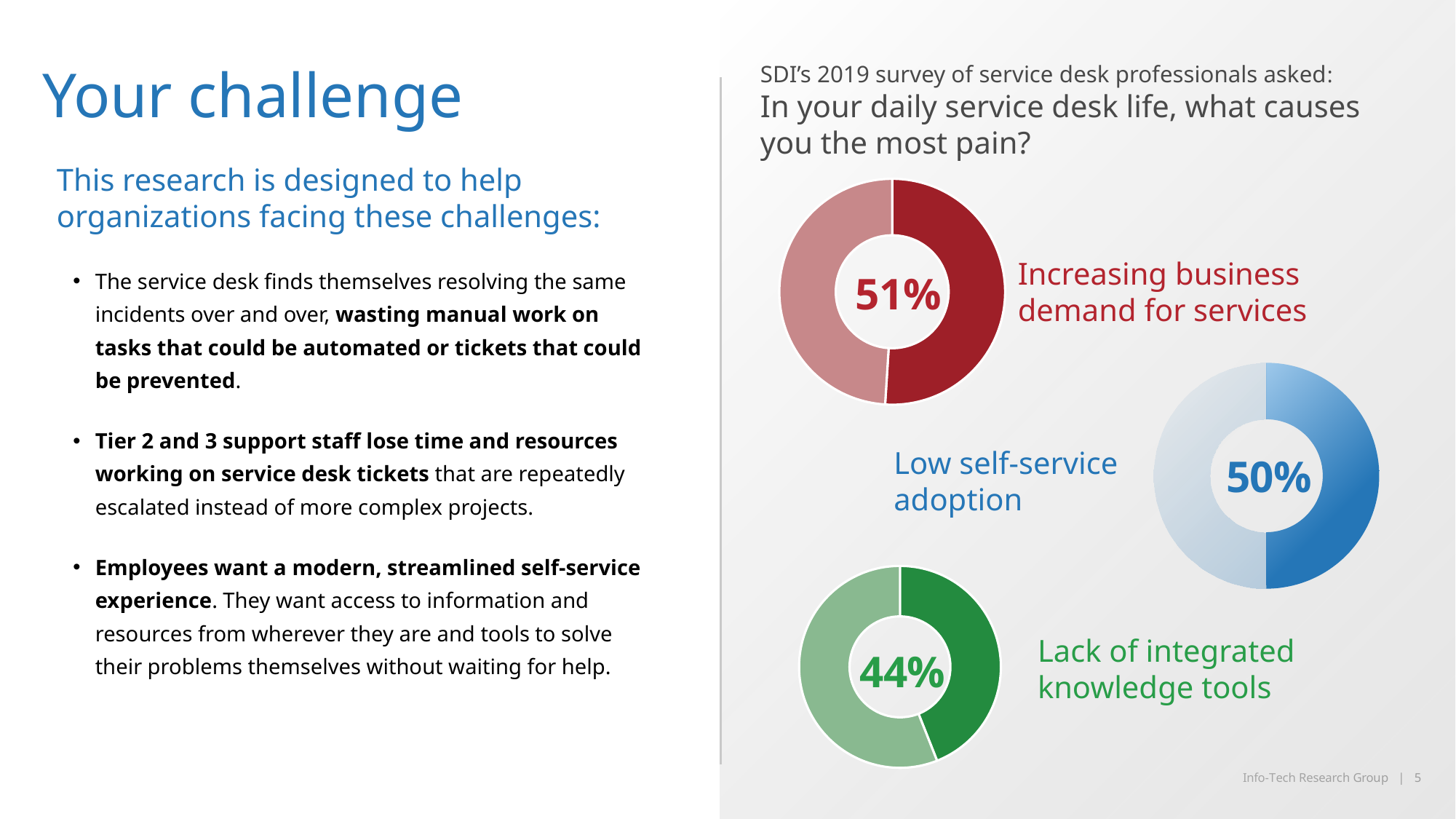
What percentage is shown for lack of integrated knowledge tools? 44% What is the difference in percentage points between increasing business demand for services and lack of integrated knowledge tools? 7 percentage points What is the difference in percentage points between increasing business demand for services and low self-service adoption? 1 percentage point What percentage of respondents cited increasing business demand for services as a pain point? 51% Which is larger: the value for low self-service adoption or the value for lack of integrated knowledge tools? Low self-service adoption Which of the three pain points has the highest percentage? Increasing business demand for services What survey question do the three donut charts answer? In your daily service desk life, what causes you the most pain? What colour is the donut chart for lack of integrated knowledge tools? Green What type of chart is used to show the survey results on the right side of the slide? Donut (pie) chart What value is shown in the donut chart for low self-service adoption? 50% Which of the three pain points has the lowest percentage? Lack of integrated knowledge tools How many donut charts are shown on the slide? 3